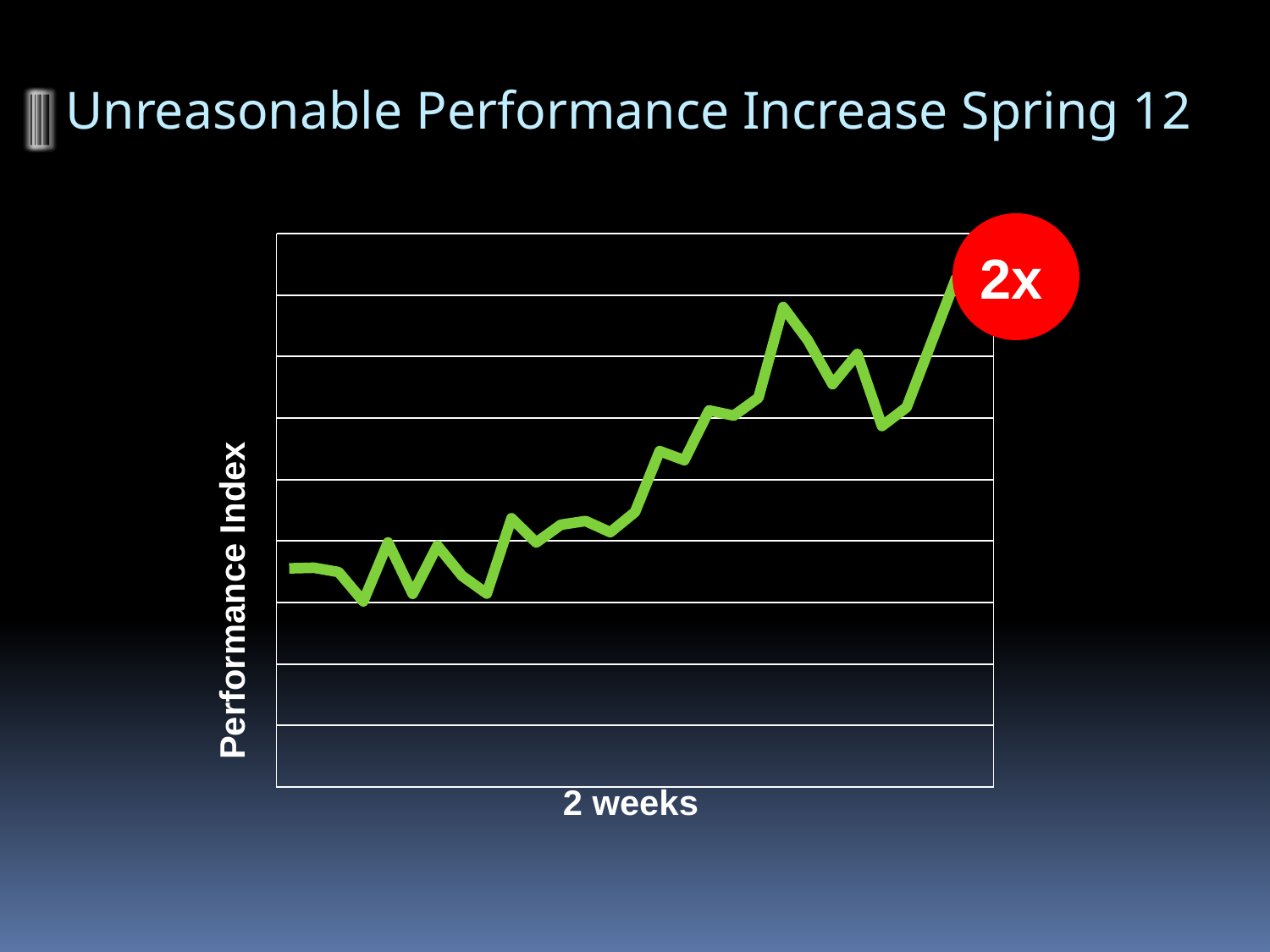
What kind of chart is shown on the slide? line chart Do the values of the Performance Index line generally rise or fall from left to right? rise What is the title of the vertical axis? Performance Index What label is shown in the red circle at the end of the line? 2x How many lines are plotted on the chart? 1 Is the last point of the line higher or lower than the first point? higher